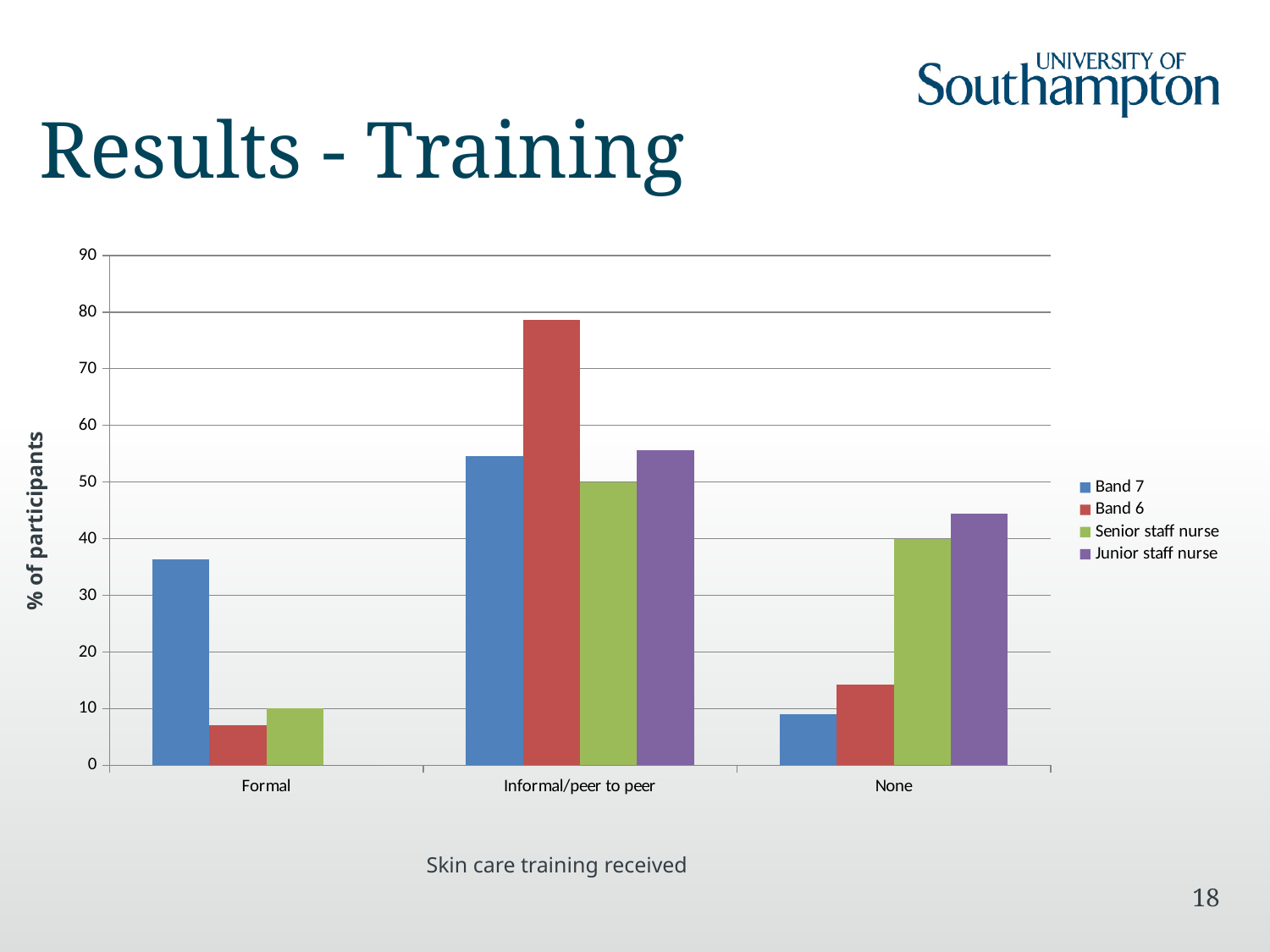
Which series has the highest value for Informal/peer to peer? Band 6 Is the value for Band 6 at Informal/peer to peer greater or less than 70? greater What kind of chart is shown on the slide? bar chart What is the label of the y axis? % of participants How many categories are shown on the x axis? 3 Which series has the lowest value for Formal training among the bars shown? Band 6 Which series has the highest value for None? Junior staff nurse Which is larger for Formal training: Band 7 or Senior staff nurse? Band 7 Which is larger for None: Senior staff nurse or Band 6? Senior staff nurse How many series does the legend list? 4 Is the value for Band 7 at Formal greater or less than 30? greater